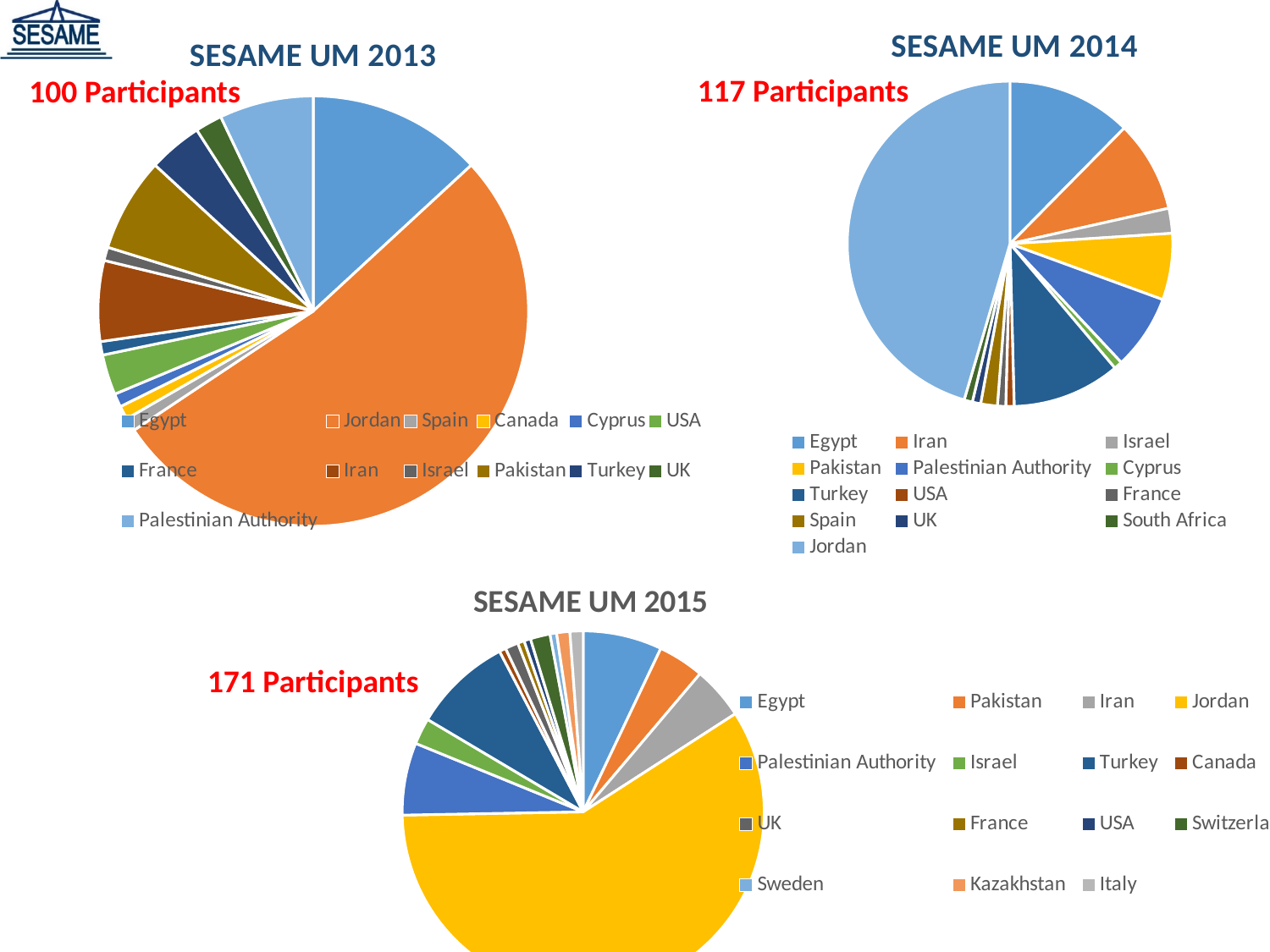
In the SESAME UM 2013 chart, which country has the largest slice? Jordan In the SESAME UM 2015 chart, which slice is larger, Turkey or Israel? Turkey In the SESAME UM 2014 chart, which slice is larger, Jordan or Turkey? Jordan In the SESAME UM 2014 chart, which country has the largest slice? Jordan In the SESAME UM 2015 chart, which country has the largest slice? Jordan How many participants does the SESAME UM 2014 chart report? 117 Participants In the SESAME UM 2013 chart, which slice is larger, Jordan or Egypt? Jordan How many participants does the SESAME UM 2015 chart report? 171 Participants How many countries does the legend of the SESAME UM 2015 chart list? 15 What kind of chart is SESAME UM 2013? Pie chart How many countries does the legend of the SESAME UM 2014 chart list? 13 How many countries does the legend of the SESAME UM 2013 chart list? 13